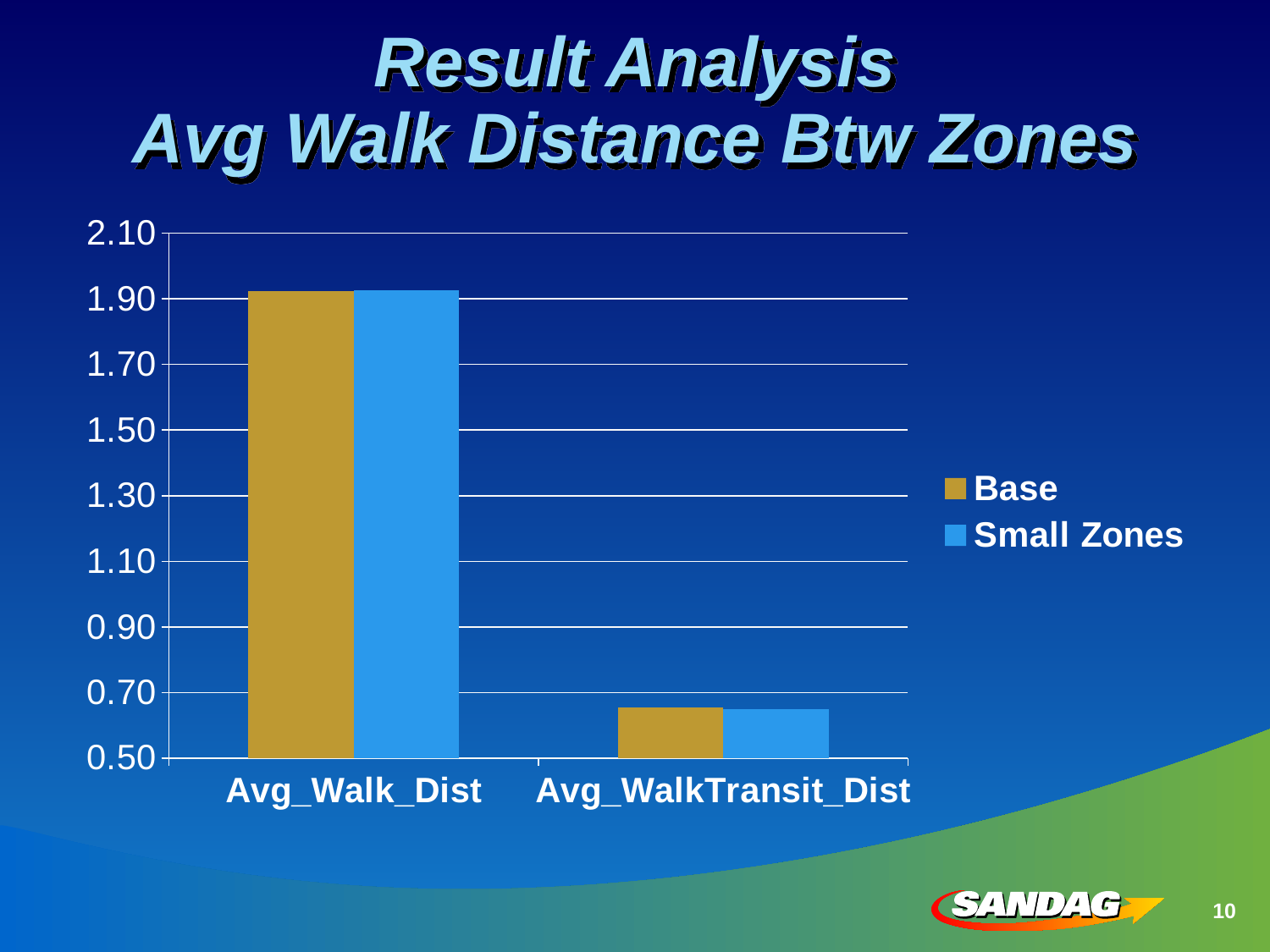
Is the Base value for Avg_Walk_Dist greater or less than 1.70? greater Is the Small Zones value for Avg_WalkTransit_Dist greater or less than 0.90? less Which series is shown in blue in the chart's legend? Small Zones Which category has the highest Base value? Avg_Walk_Dist How many categories are shown on the x axis of the chart? 2 Is the Base value for Avg_WalkTransit_Dist greater or less than 0.70? less For the Base series, which is larger: Avg_Walk_Dist or Avg_WalkTransit_Dist? Avg_Walk_Dist What is the title of the slide containing the chart? Result Analysis Avg Walk Distance Btw Zones Which category has the lowest Small Zones value? Avg_WalkTransit_Dist What kind of chart is shown on the slide? bar chart How many series does the chart's legend list? 2